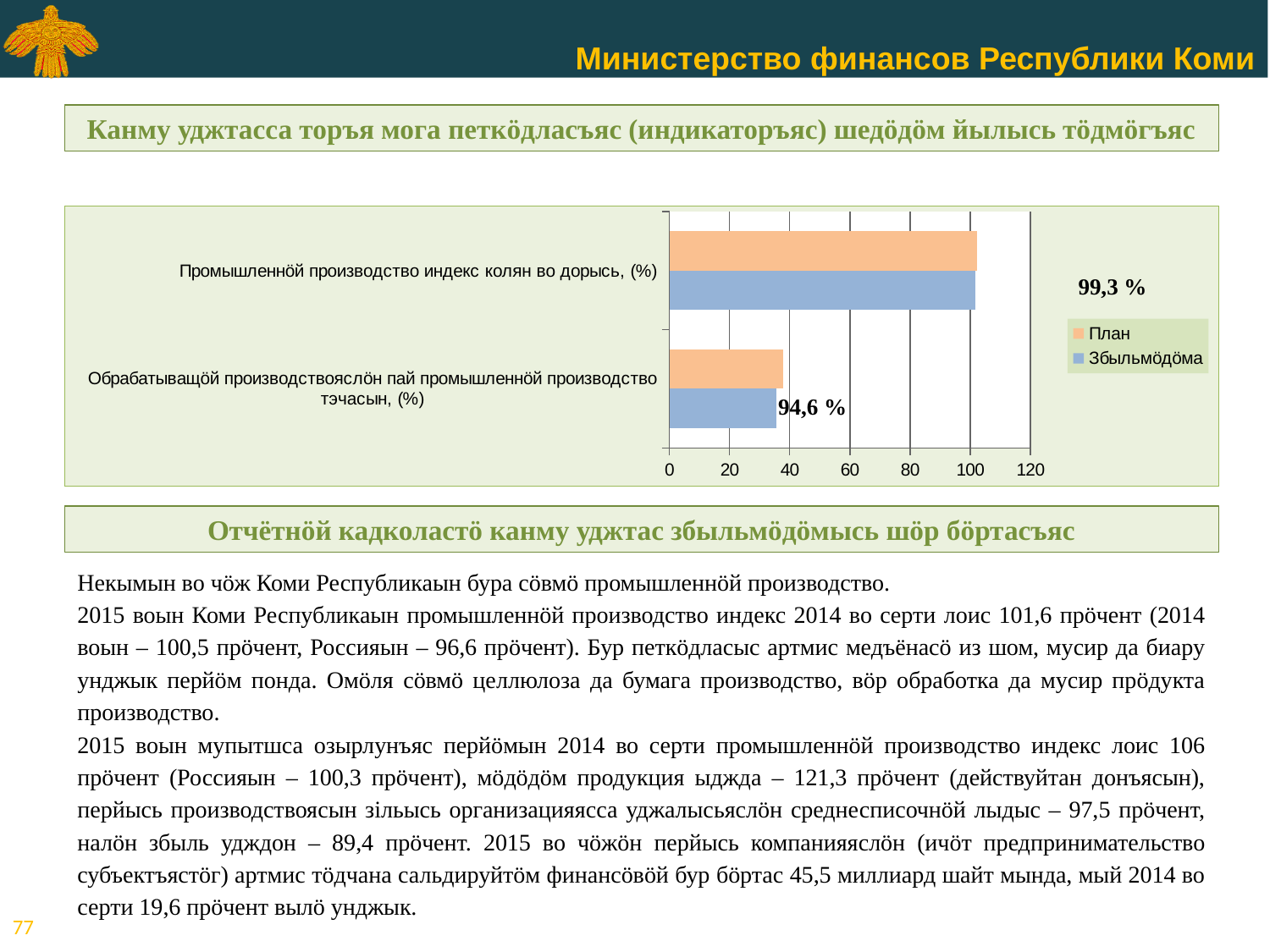
Which category has the lowest План value in the chart? Обрабатывающӧй производствояслӧн пай промышленнӧй производство тэчасын, (%) Which category has the higher Збыльмӧдӧма value: 'Промышленнӧй производство индекс колян во дорысь, (%)' or 'Обрабатывающӧй производствояслӧн пай промышленнӧй производство тэчасын, (%)'? Промышленнӧй производство индекс колян во дорысь, (%) How many categories does the bar chart show? 2 Which colour represents the План series in the chart? orange Is the План value for 'Обрабатывающӧй производствояслӧн пай промышленнӧй производство тэчасын, (%)' greater or less than 60? less What is the maximum value shown on the chart's horizontal axis? 120 Is the Збыльмӧдӧма value for 'Обрабатывающӧй производствояслӧн пай промышленнӧй производство тэчасын, (%)' greater or less than 20? greater How many series does the chart legend list? 2 What are the two series named in the chart legend? План and Збыльмӧдӧма Is the План value for 'Промышленнӧй производство индекс колян во дорысь, (%)' greater or less than 80? greater What kind of chart is shown on the slide? bar chart